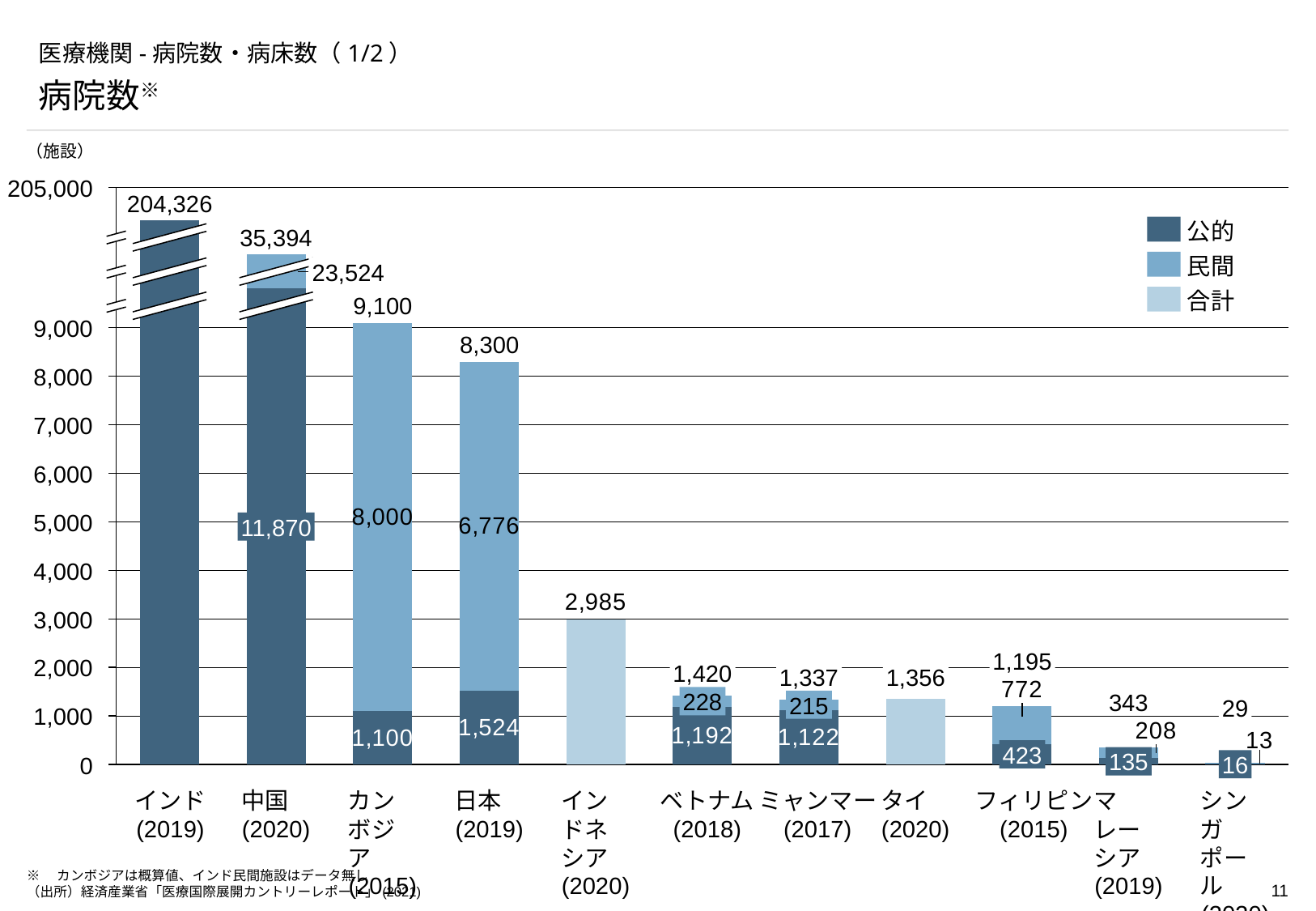
What is the 民間 (private) value shown for カンボジア (2015)? 8,000 What is the difference between the 民間 value and the 公的 value for 日本 (2019)? 5,252 Which country has the lowest total number of hospitals? シンガポール (2020) What kind of chart is shown on the slide? Stacked bar chart What is the 公的 (public) value shown for 中国 (2020)? 11,870 Which is larger, the total for ベトナム (2018) or the total for ミャンマー (2017)? ベトナム (2018) What is the total of the stacked bar for フィリピン (2015)? 1,195 What is the value shown for インドネシア (2020)? 2,985 What is the total number of hospitals shown for 日本 (2019)? 8,300 How many countries are shown on the x axis? 11 How many series does the legend list? 3 Which country has the highest total number of hospitals? インド (2019)